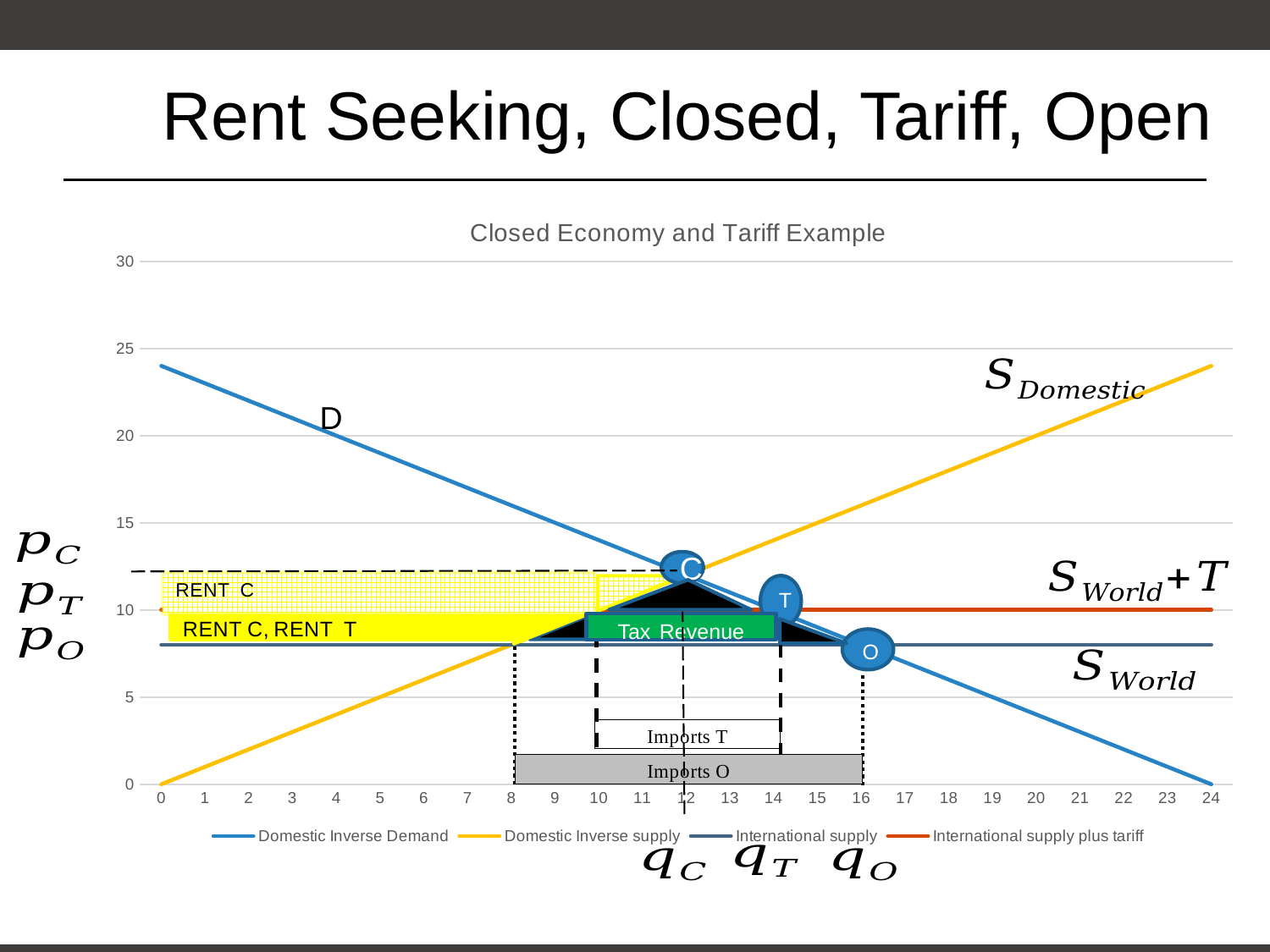
Is the value of Domestic Inverse supply at quantity 12 greater or less than 15? less Does the Domestic Inverse Demand line rise or fall as quantity increases? fall What is the value of the International supply plus tariff line? 10 At quantity 4, which is higher: Domestic Inverse Demand or Domestic Inverse supply? Domestic Inverse Demand Is the value of the International supply line greater or less than 10? less What is the value of Domestic Inverse Demand at quantity 24? 0 What is the value of Domestic Inverse supply at quantity 0? 0 What label is written in the green box on the chart? Tax Revenue What type of chart is shown on the slide? line chart Is the value of Domestic Inverse Demand at quantity 0 greater or less than 20? greater What is the title of the chart? Closed Economy and Tariff Example How many series does the legend list? 4